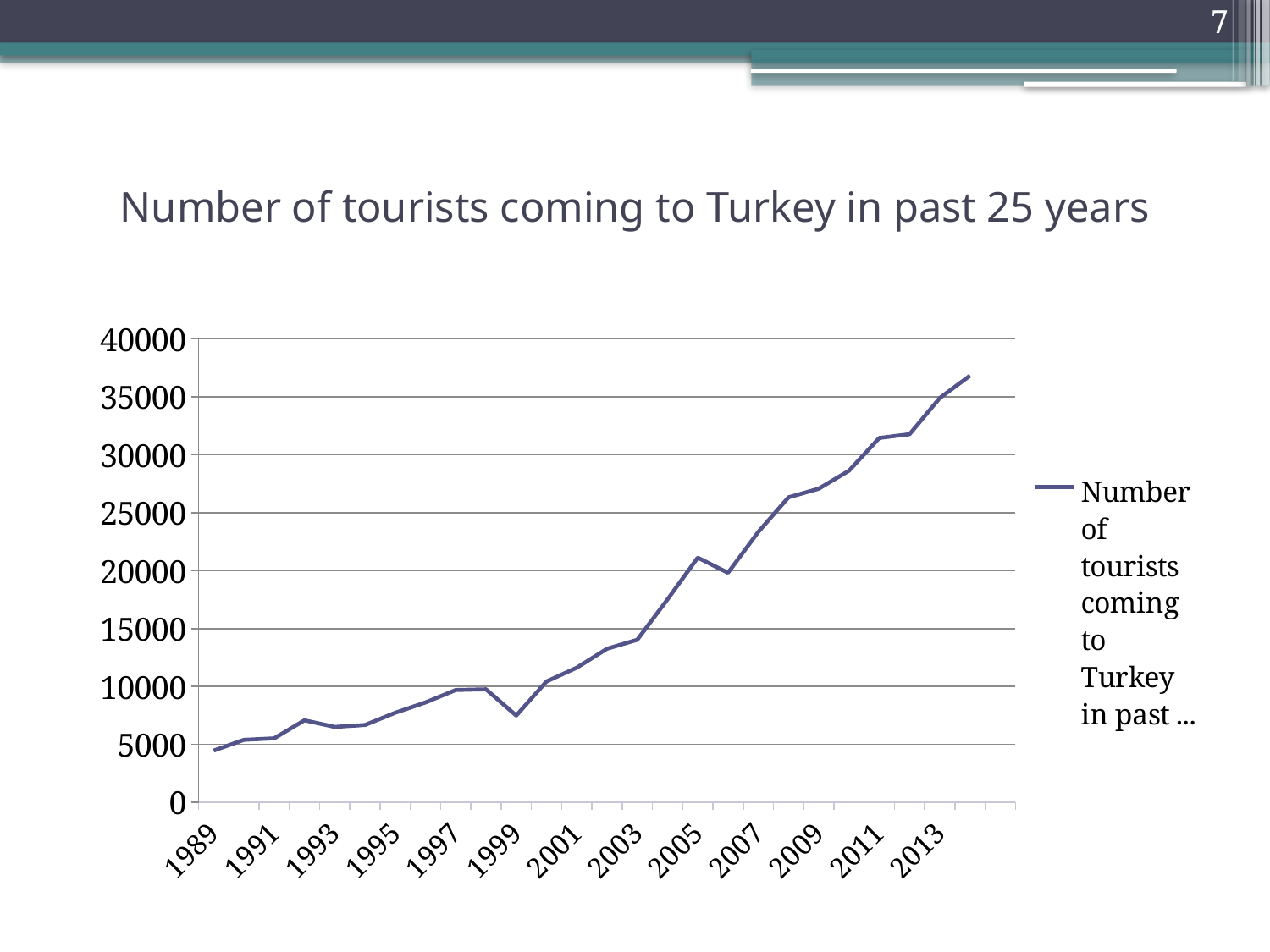
Is the value for 1999 greater or less than 10000? less What kind of chart is shown on the slide? line chart Which year has the larger value, 2003 or 2011? 2011 Is the value for 2009 greater or less than 25000? greater How many years (data points) are plotted on the x axis? 26 What is the title of the chart? Number of tourists coming to Turkey in past 25 years Which year has the lowest number of tourists? 1989 How many series does the legend list? 1 Is the value for 1989 greater or less than 5000? less Which year has the highest number of tourists? 2014 Overall, do the values rise or fall from 1989 to 2013? rise